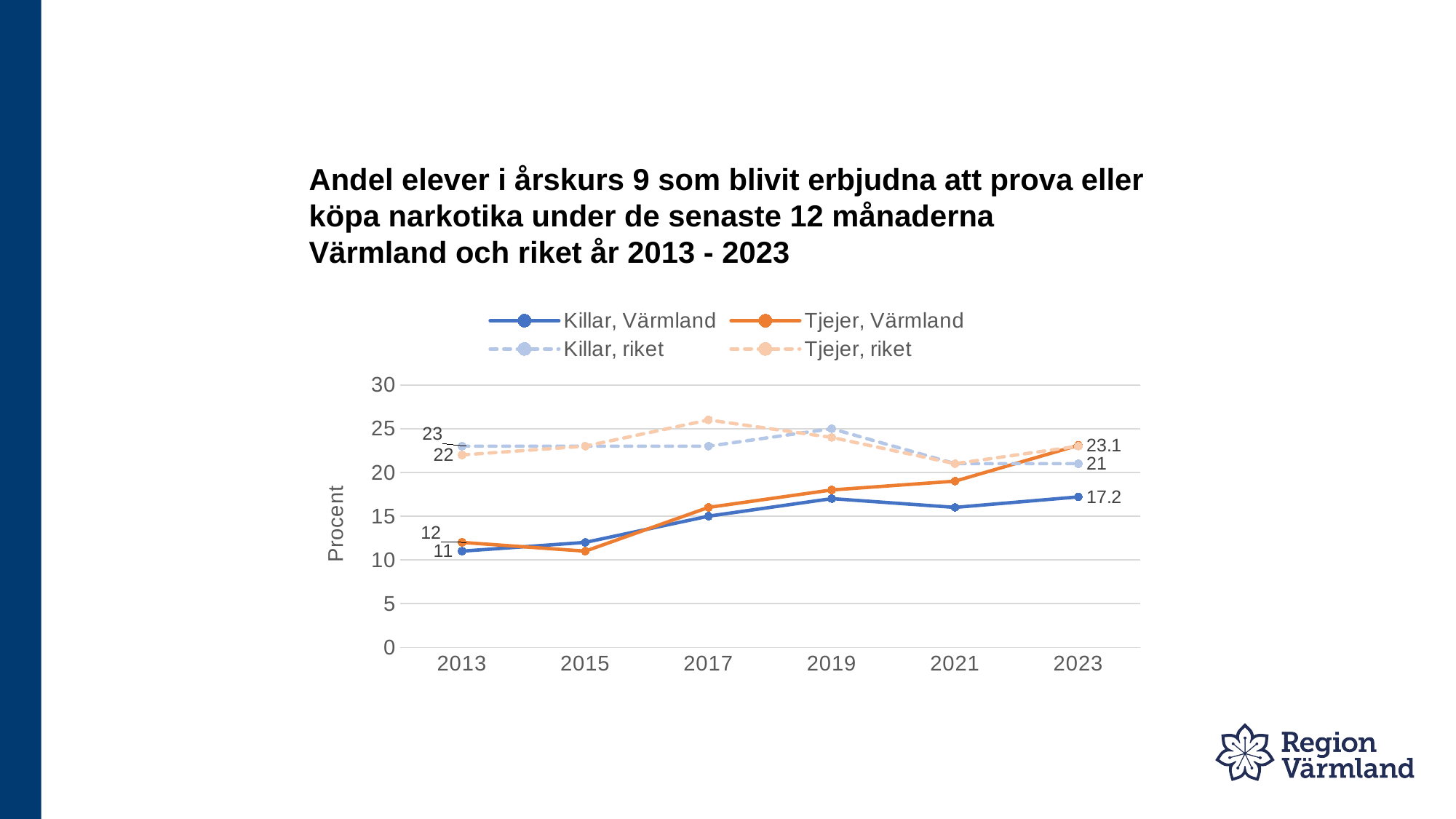
What is the value for Killar, Värmland in 2023? 17.2 What kind of chart is shown on the slide? line chart How many years are shown on the x axis? 6 What is the value for Killar, riket in 2013? 23 What is the value for Killar, riket in 2023? 21 How many series does the legend list? 4 What is the difference between Killar, riket in 2013 and Killar, riket in 2023? 2 Is the value for Tjejer, riket in 2017 greater or less than 25? greater What is the value for Killar, Värmland in 2013? 11 By how much did the value for Killar, Värmland increase from 2013 to 2023? 6.2 Which is larger in 2013: Killar, riket or Killar, Värmland? Killar, riket What is the value for Tjejer, Värmland in 2013? 12